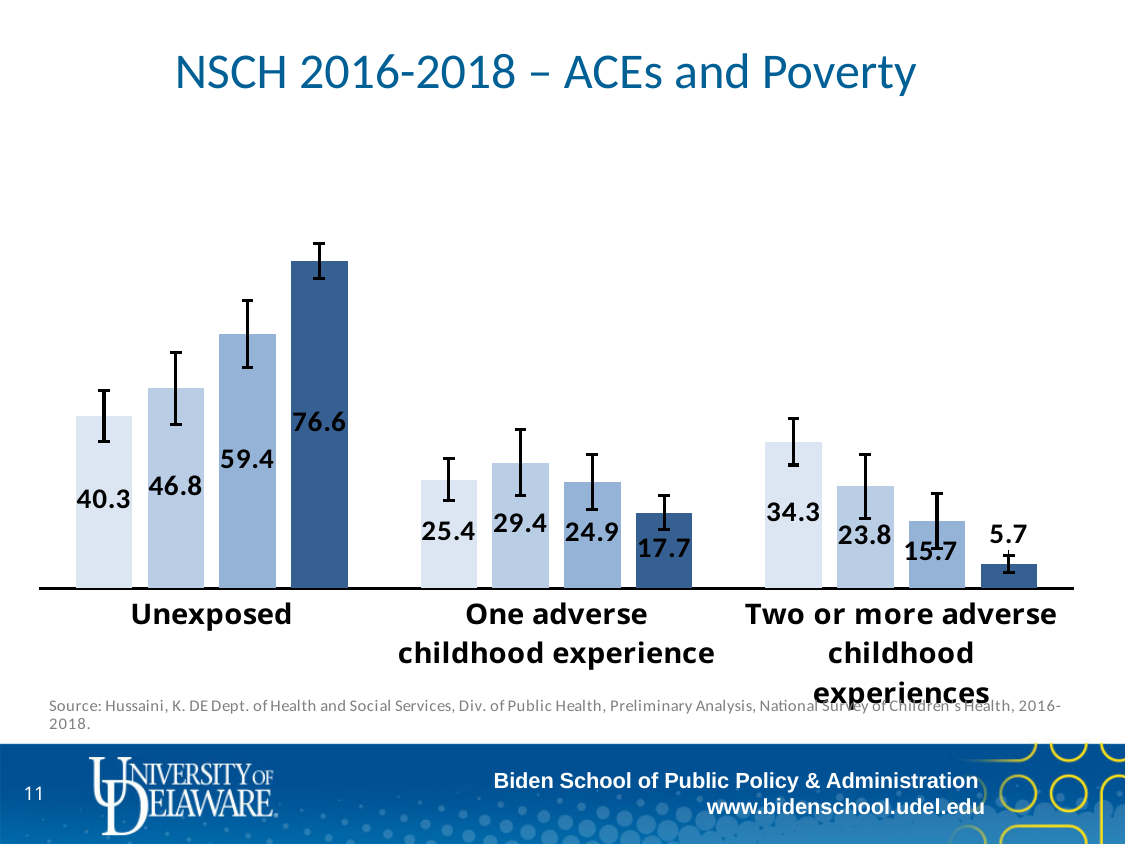
What is the value of the darkest (fourth) bar in the Unexposed group? 76.6 What is the value of the second bar in the One adverse childhood experience group? 29.4 Which bar in the Two or more adverse childhood experiences group has the lowest value? The darkest (fourth) bar, 5.7 What kind of chart is shown on the slide? Bar chart Which bar in the Unexposed group has the highest value? The darkest (fourth) bar, 76.6 What is the title of the slide? NSCH 2016-2018 – ACEs and Poverty What is the value of the lightest (first) bar in the Two or more adverse childhood experiences group? 34.3 How many category groups are shown on the x axis? 3 Which is larger: the second bar in the One adverse childhood experience group or the second bar in the Two or more adverse childhood experiences group? The second bar in the One adverse childhood experience group (29.4) How many bars are in each category group? 4 What is the difference between the darkest bar and the lightest bar in the Unexposed group? 36.3 What is the difference between the lightest bar and the darkest bar in the Two or more adverse childhood experiences group? 28.6